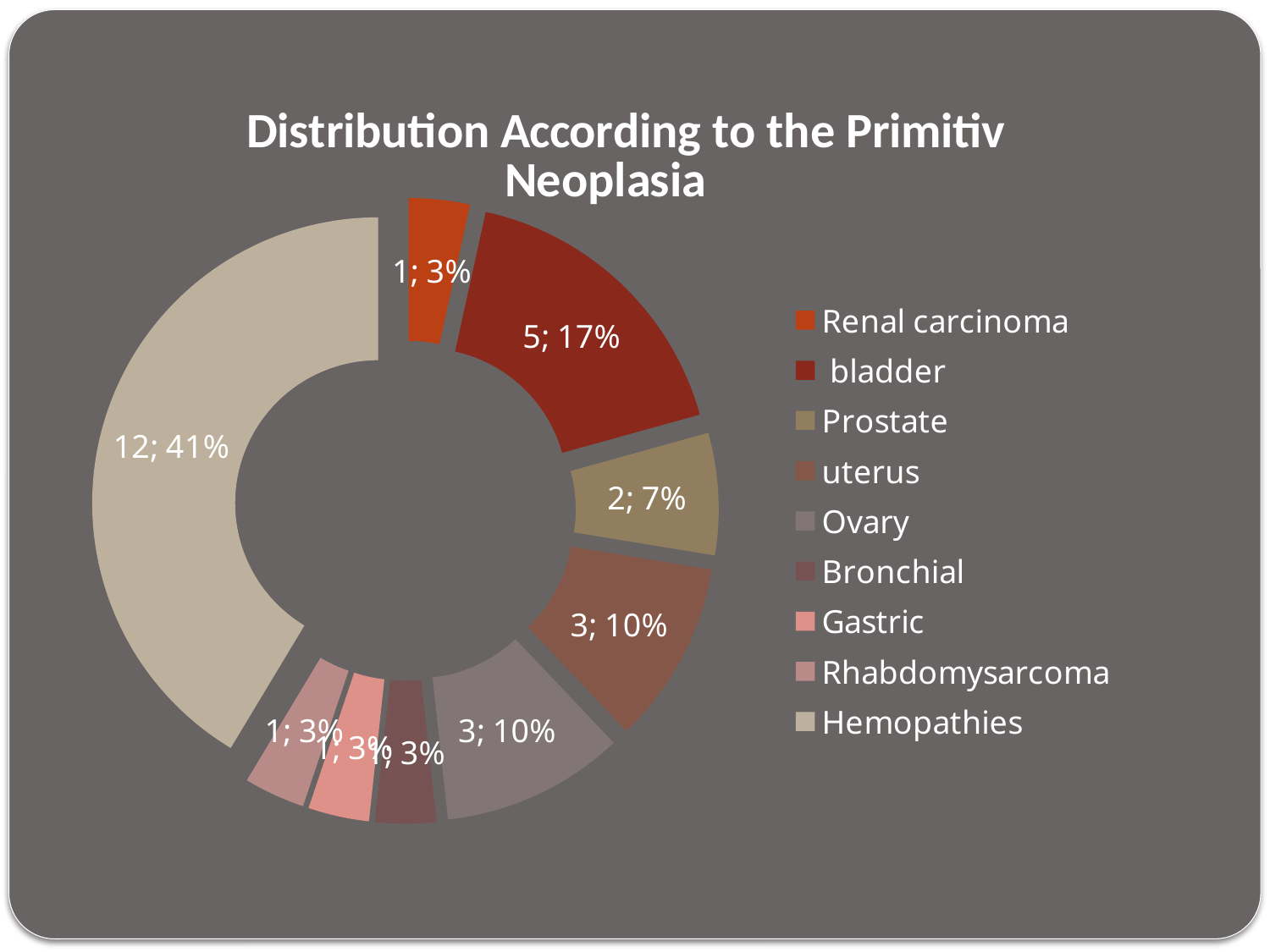
Which has a larger share, bladder or Prostate? bladder What percentage share does Hemopathies have? 41% What is the count shown for bladder? 5 What is the count shown for Hemopathies? 12 What is the count shown for uterus? 3 What percentage share does bladder have? 17% Which category has the largest share? Hemopathies What percentage share does Prostate have? 7% What is the difference in count between Hemopathies and bladder? 7 How many categories does the legend list? 9 What is the title of the chart? Distribution According to the Primitiv Neoplasia What kind of chart is shown on the slide? Doughnut (pie) chart